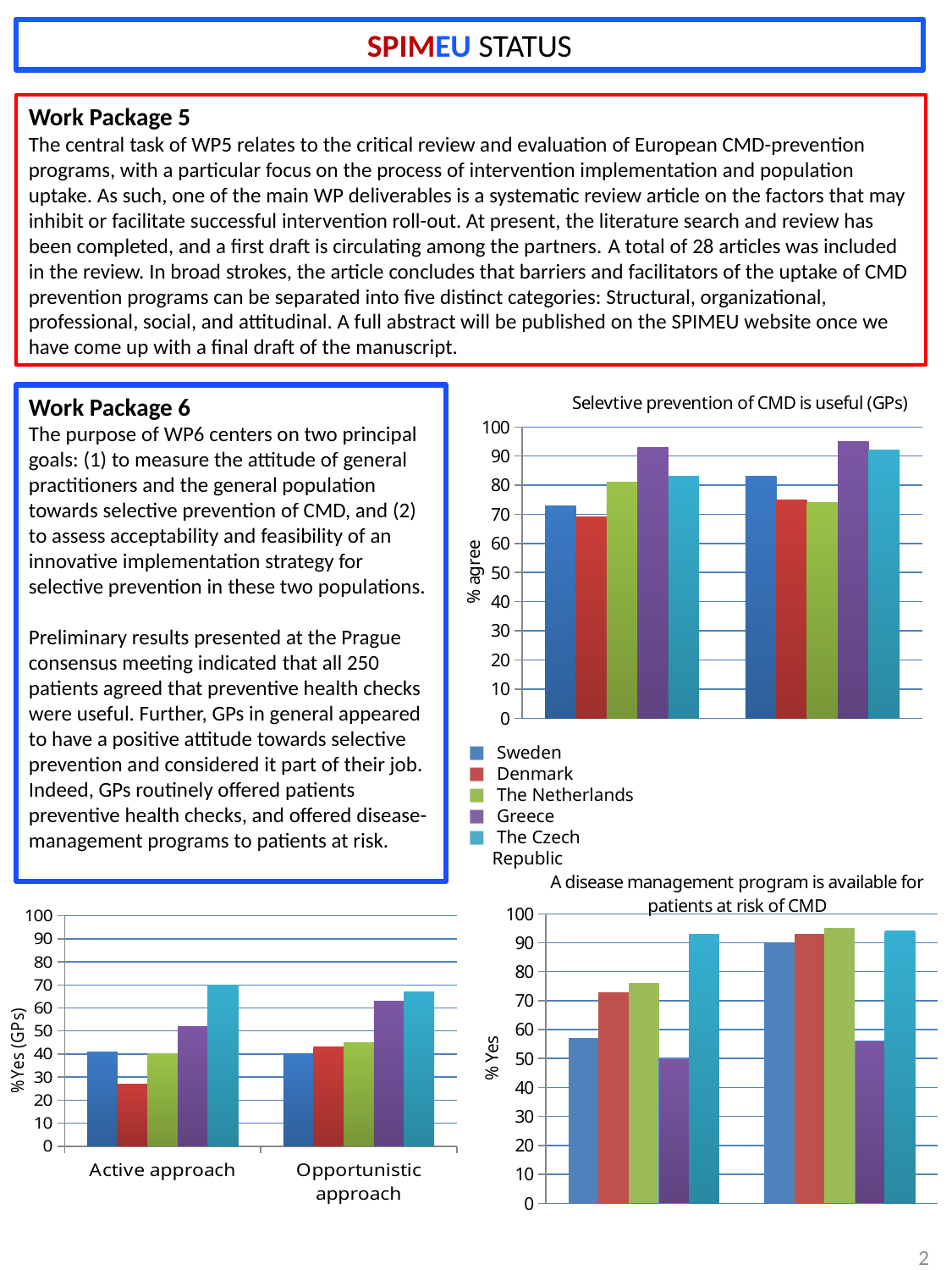
In the 'Selevtive prevention of CMD is useful (GPs)' chart, is the value for Greece in the first group greater or less than 90? greater In the 'Selevtive prevention of CMD is useful (GPs)' chart, which is larger in the first group: Greece or The Czech Republic? Greece In the bottom-left chart, is the shortest bar for Active approach greater or less than 30? less In the 'Selevtive prevention of CMD is useful (GPs)' chart, which country has the lowest bar in the first group of bars? Denmark In the bottom-left chart, is the tallest bar for Active approach greater or less than 60? greater What kind of chart is the 'Selevtive prevention of CMD is useful (GPs)' chart? bar chart How many series does the legend of the 'Selevtive prevention of CMD is useful (GPs)' chart list? 5 What is the y-axis label of the 'A disease management program is available for patients at risk of CMD' chart? % Yes In the 'Selevtive prevention of CMD is useful (GPs)' chart, which country has the highest bar in the first group of bars? Greece How many categories are shown on the x axis of the bottom-left chart? 2 What are the two x-axis category labels on the bottom-left chart? Active approach and Opportunistic approach